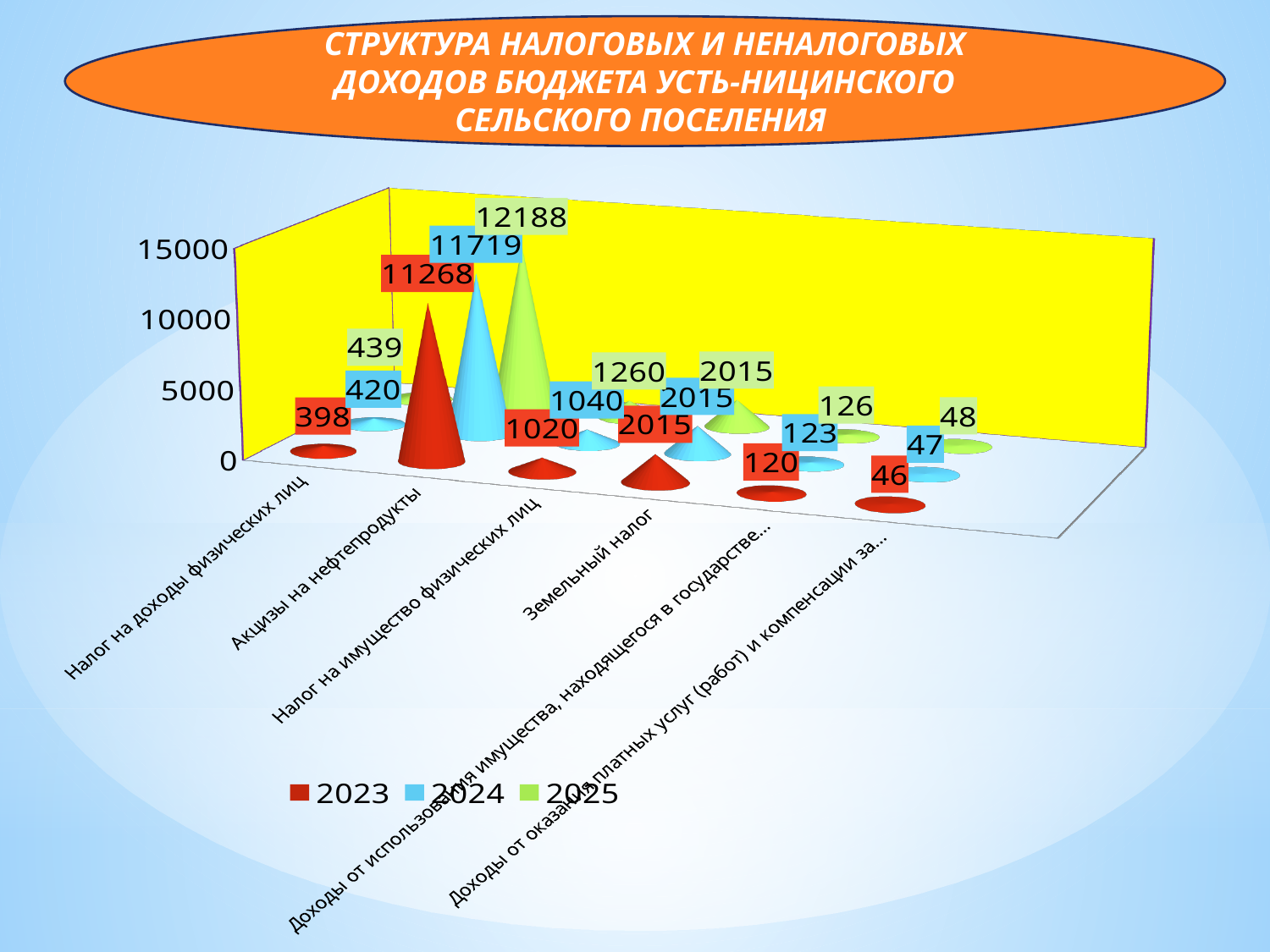
What kind of chart is shown on the slide? 3D bar chart (cone) What is the 2025 value for Земельный налог? 2015 What is the 2024 value for Налог на имущество физических лиц? 1040 How many series does the legend list? 3 Which is larger: the 2024 value for Налог на имущество физических лиц or the 2024 value for Земельный налог? Земельный налог What is the 2025 value for Налог на доходы физических лиц? 439 Which category has the lowest 2023 value? Доходы от оказания платных услуг (работ) и компенсации за... What is the 2023 value for Акцизы на нефтепродукты? 11268 How many categories are shown on the x axis? 6 What is the difference between the 2025 and 2023 values for Акцизы на нефтепродукты? 920 Which category has the highest 2025 value? Акцизы на нефтепродукты Which colour represents the 2024 series in the legend? Blue